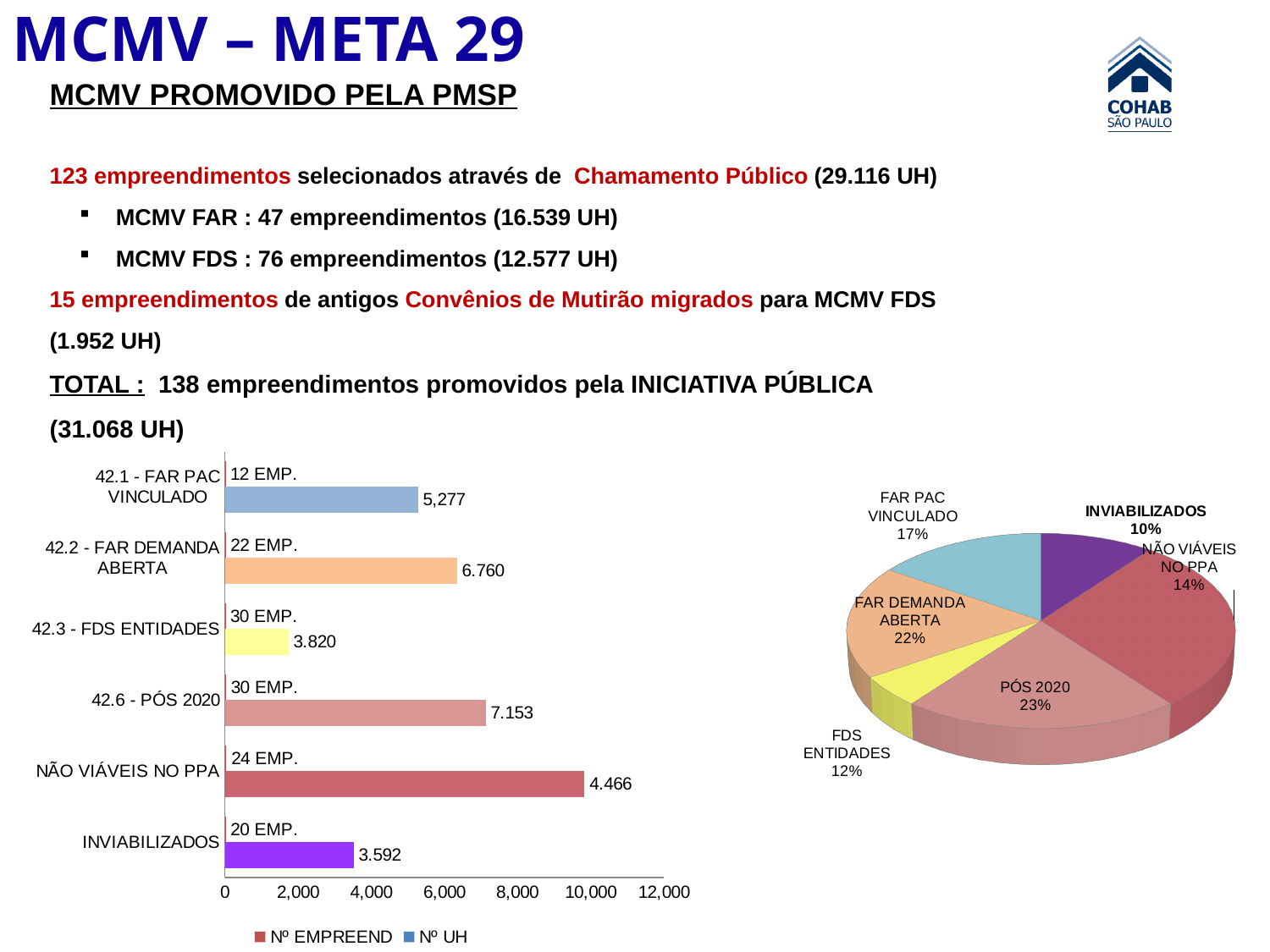
In the bar chart on the left, how many categories are shown? 6 In the bar chart on the left, what is the Nº UH value for 42.1 - FAR PAC VINCULADO? 5,277 In the bar chart on the left, what is the difference in Nº UH between 42.2 - FAR DEMANDA ABERTA and 42.3 - FDS ENTIDADES? 2.940 In the bar chart on the left, how many series does the legend list? 2 In the bar chart on the left, which has a larger Nº UH value: NÃO VIÁVEIS NO PPA or INVIABILIZADOS? NÃO VIÁVEIS NO PPA In the bar chart on the left, how many EMP. are shown for 42.3 - FDS ENTIDADES? 30 EMP. In the bar chart on the left, what is the Nº UH value for 42.6 - PÓS 2020? 7.153 What type of chart is shown on the right side of the slide? Pie chart In the pie chart on the right, what share does PÓS 2020 have? 23%